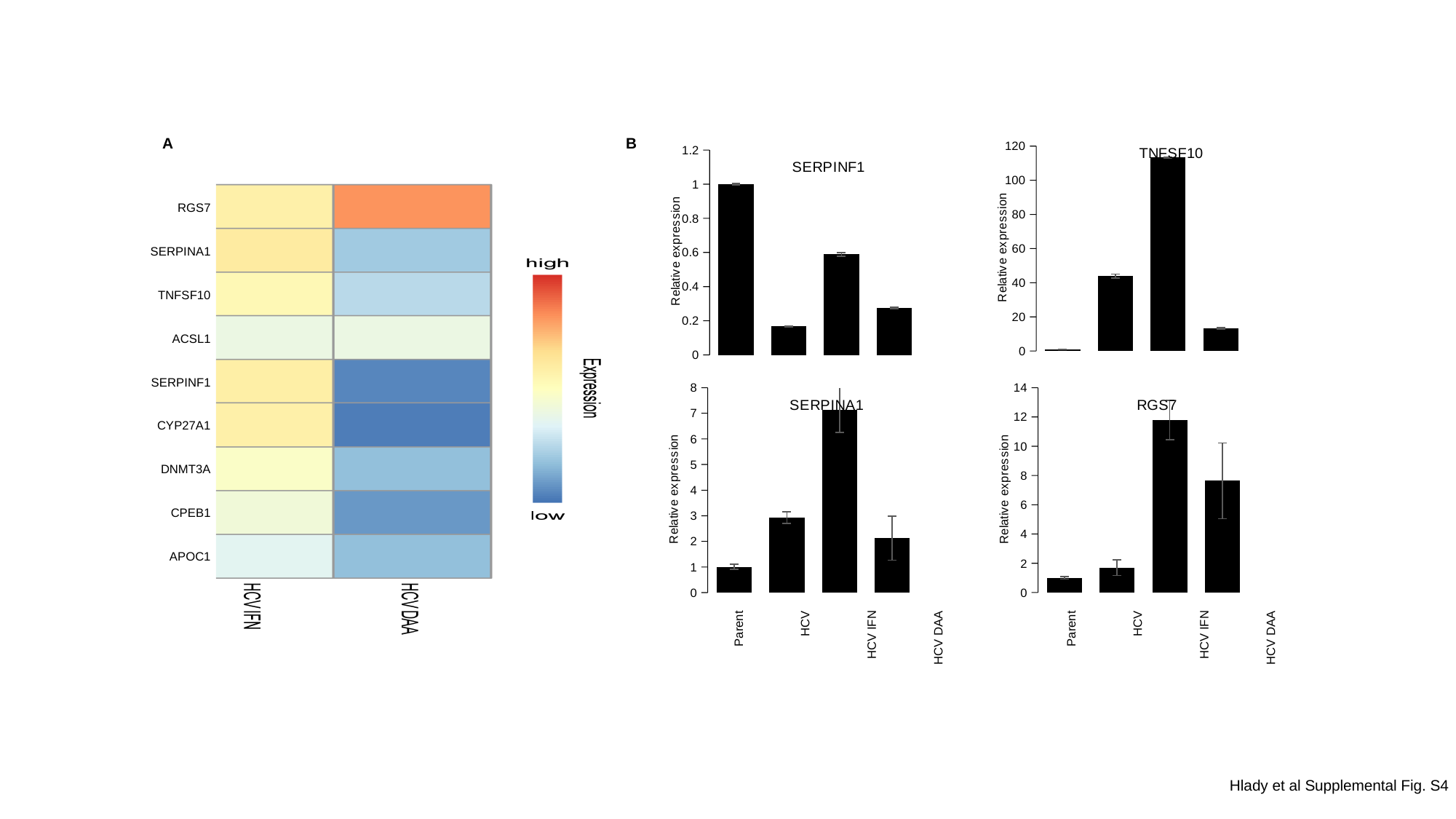
In the SERPINA1 chart, which category has the highest relative expression? HCV IFN In the RGS7 chart, is the value for HCV IFN greater or less than 10? greater In the SERPINF1 chart, which category has the highest relative expression? Parent In the SERPINF1 chart, what is the relative expression for Parent? 1 In the TNFSF10 chart, which category has the highest relative expression? HCV IFN In the SERPINF1 chart, which category has the lowest relative expression? HCV How many categories are shown on the x axis of the SERPINF1 chart? 4 In the TNFSF10 chart, is the value for HCV IFN greater or less than 100? greater What is the y-axis label on the bar charts in panel B? Relative expression What kind of chart is the SERPINF1 chart in panel B? bar chart In the TNFSF10 chart, which category has the lowest relative expression? Parent